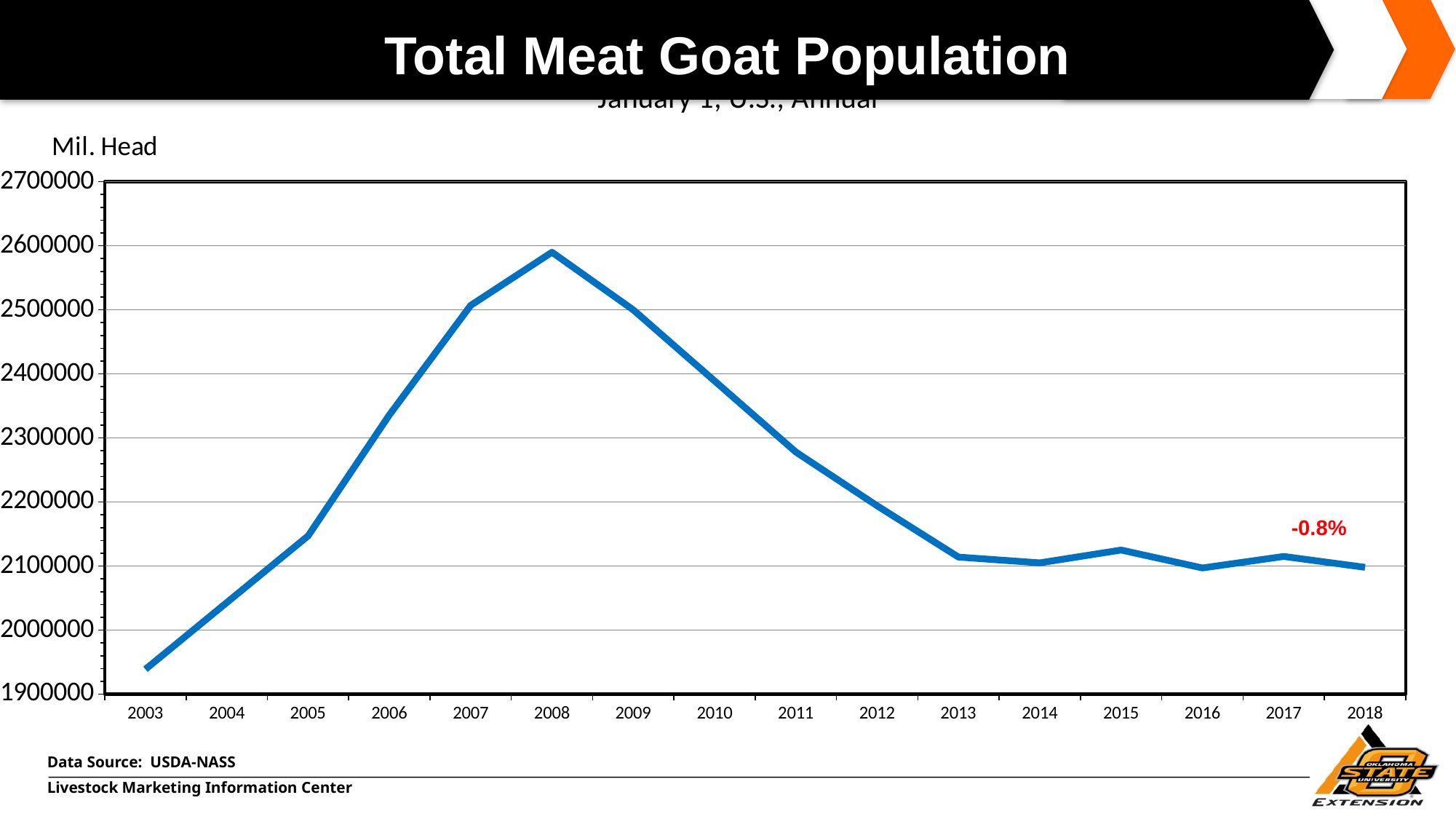
Is the value for 2008 greater or less than 2500000? greater Is the value for 2003 greater or less than 2000000? less Does the meat goat population rise or fall from 2003 to 2008? rise What percentage change is annotated in red near the 2018 end of the line? -0.8% In which year is the total meat goat population lowest? 2003 What unit label is shown above the y axis? Mil. Head Does the meat goat population rise or fall from 2008 to 2013? fall In which year is the total meat goat population highest? 2008 Which year has the larger meat goat population, 2006 or 2012? 2006 How many years are plotted along the x axis? 16 What kind of chart is shown on the slide? line chart